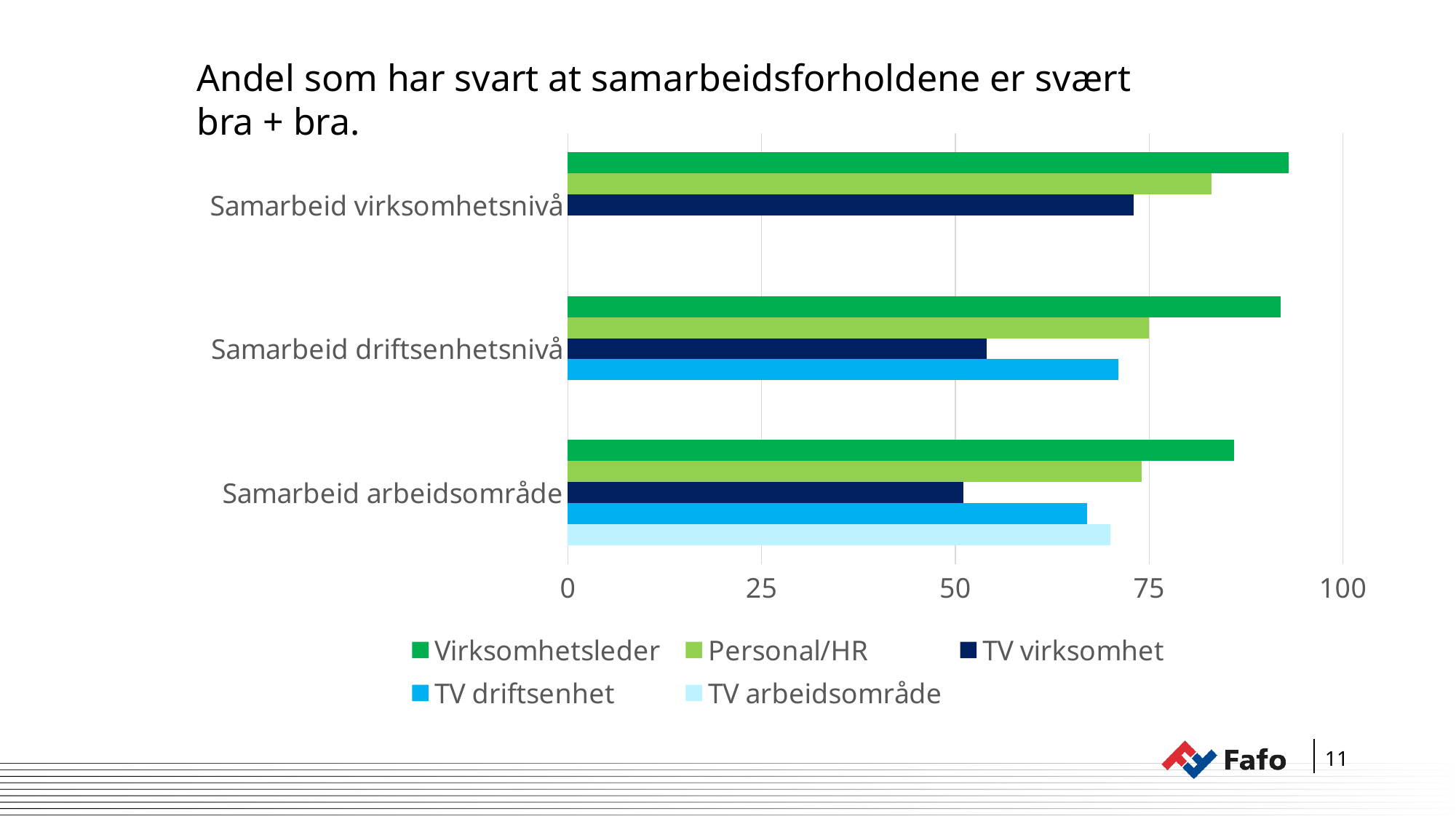
Is the value for Virksomhetsleder in Samarbeid virksomhetsnivå greater or less than 75? greater Which category has bars for all five series? Samarbeid arbeidsområde For Samarbeid arbeidsområde, which series has the highest value? Virksomhetsleder Is the value for TV virksomhet in Samarbeid driftsenhetsnivå greater or less than 75? less In Samarbeid driftsenhetsnivå, which is larger: TV driftsenhet or TV virksomhet? TV driftsenhet For Samarbeid arbeidsområde, which series has the lowest value? TV virksomhet What kind of chart is shown on the slide? Bar chart For Samarbeid driftsenhetsnivå, which series has the lowest value? TV virksomhet Is the value for TV arbeidsområde in Samarbeid arbeidsområde greater or less than 50? greater How many categories are shown on the vertical axis? 3 How many series does the legend list? 5 In Samarbeid virksomhetsnivå, which is larger: Personal/HR or TV virksomhet? Personal/HR